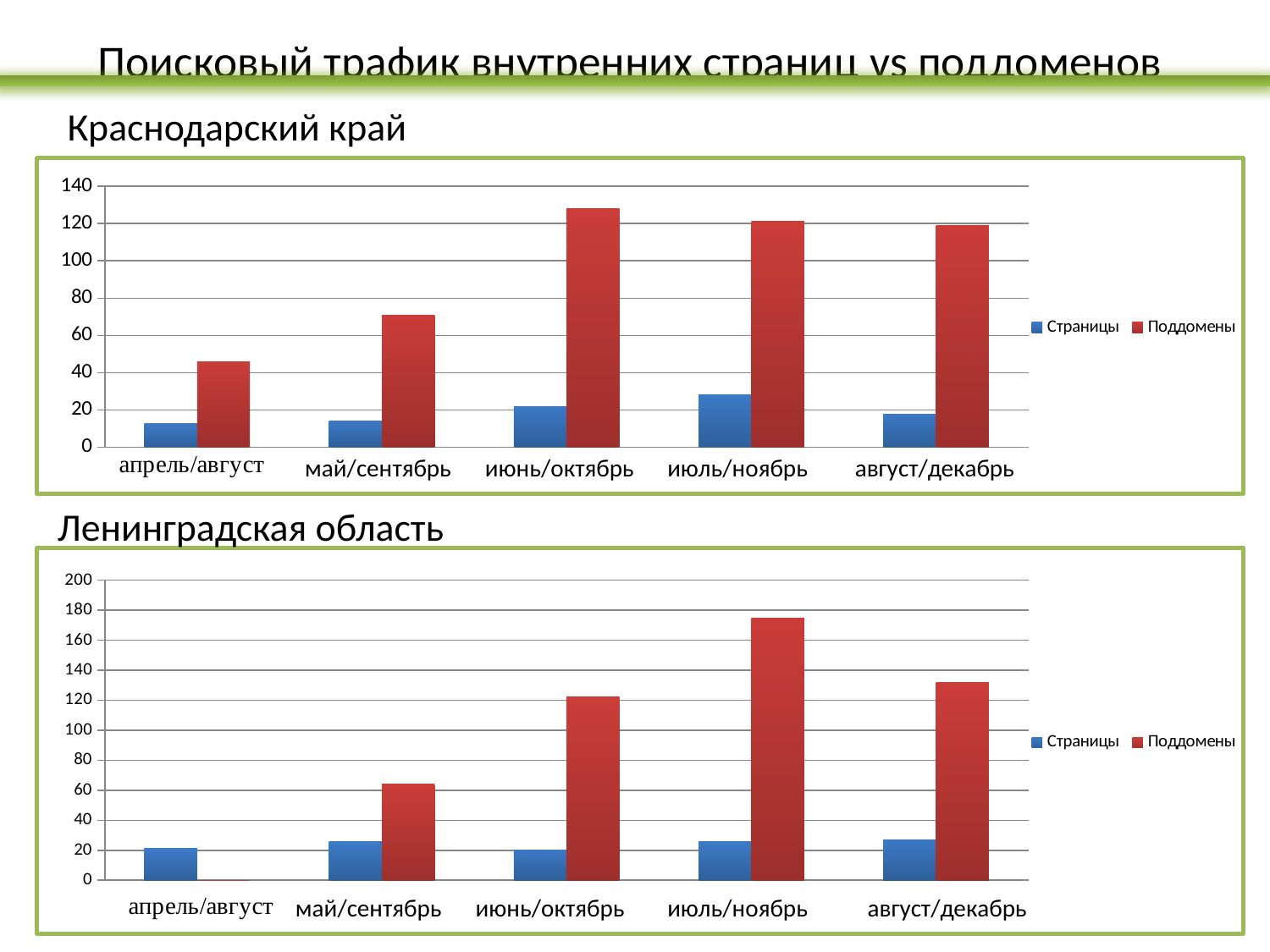
In the Краснодарский край chart, is the Поддомены value for апрель/август greater or less than 60? less In the Ленинградская область chart, which is larger: the Поддомены value for июль/ноябрь or for август/декабрь? июль/ноябрь In the Краснодарский край chart, which category has the highest Страницы value? июль/ноябрь In the Краснодарский край chart, which category has the lowest Поддомены value? апрель/август In the Ленинградская область chart, which category has the lowest Поддомены value? апрель/август In the Краснодарский край chart, is the Поддомены value for июнь/октябрь greater or less than 120? greater In the Ленинградская область chart, which category has the highest Поддомены value? июль/ноябрь In the Ленинградская область chart, is the Поддомены value for июль/ноябрь greater or less than 160? greater What kind of chart is the Краснодарский край chart? bar chart How many categories are shown on the x axis of the Краснодарский край chart? 5 In the Краснодарский край chart, which category has the highest Поддомены value? июнь/октябрь How many series does the legend of the Ленинградская область chart list? 2